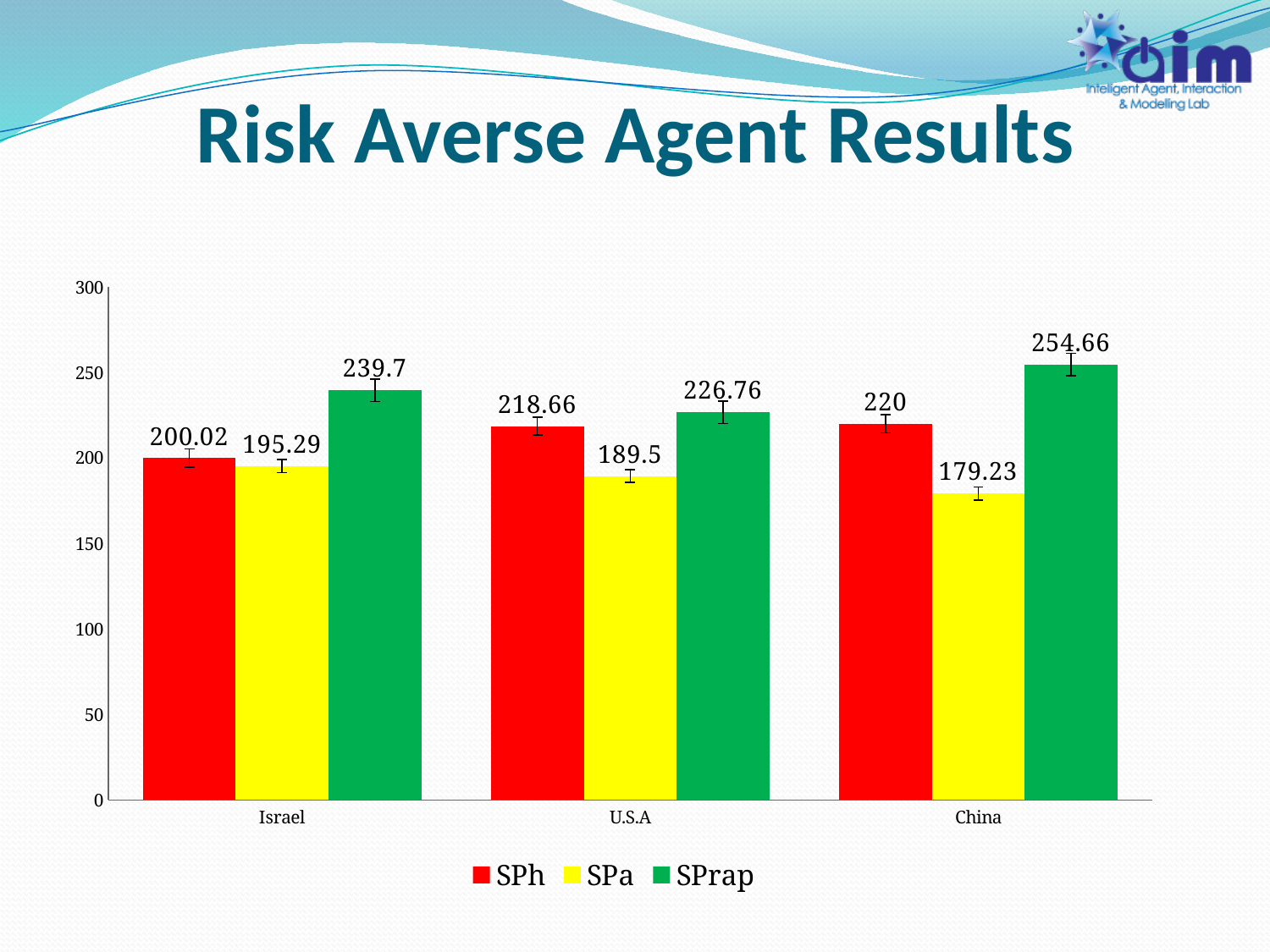
What is the SPa value for U.S.A? 189.5 What is the SPh value for China? 220 How many series does the legend list? 3 Which country has the lowest SPa value? China Which country has the highest SPrap value? China What is the SPh value for Israel? 200.02 How many countries are shown on the x axis? 3 Is the SPa value for Israel greater or less than 200? less What is the difference between the SPrap and SPa values for China? 75.43 What kind of chart is shown on the slide? bar chart What is the SPrap value for China? 254.66 Which is larger for U.S.A, the SPh value or the SPrap value? SPrap